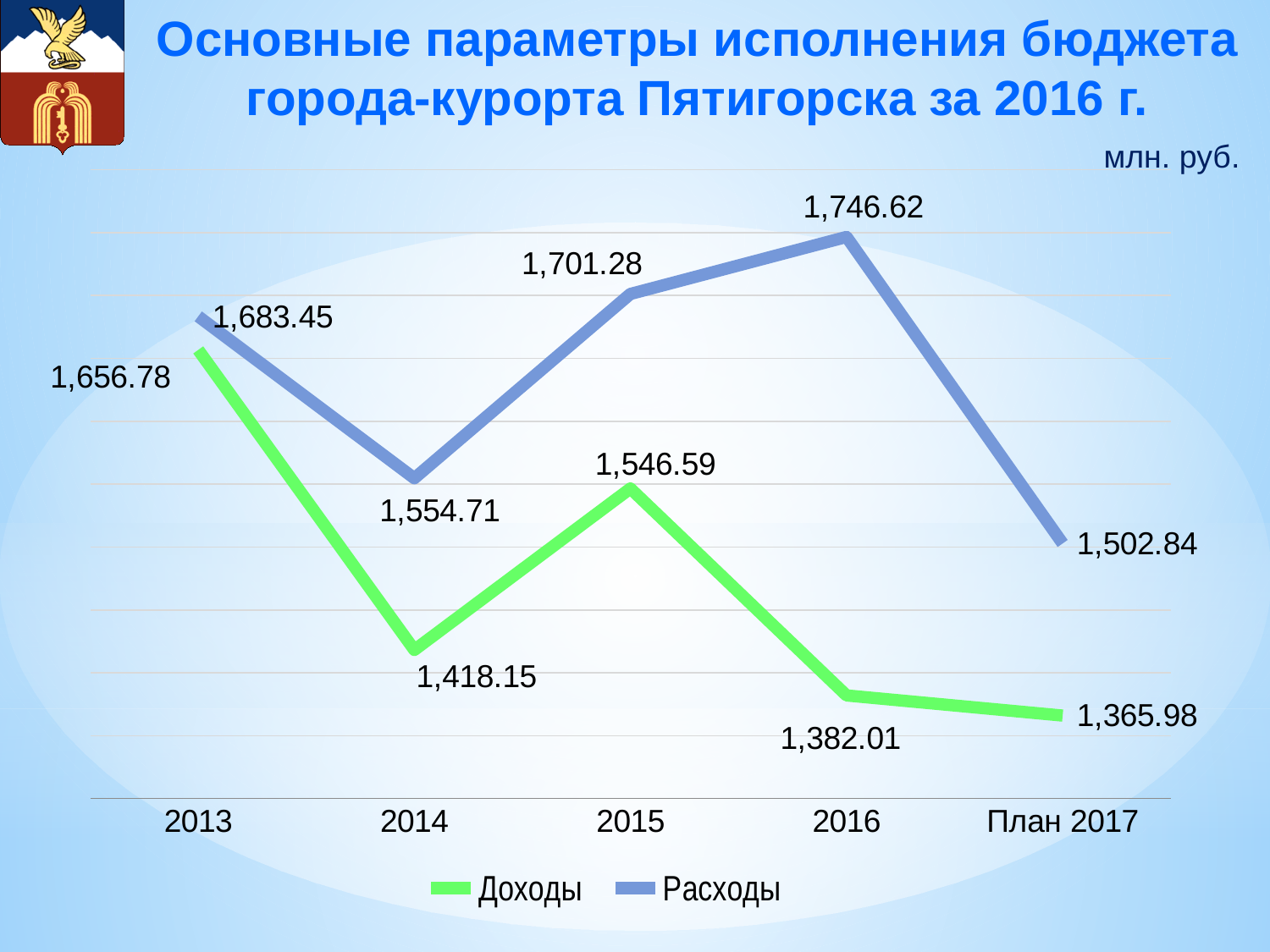
What is the value of Расходы for 2015? 1,701.28 What is the value of Доходы for 2014? 1,418.15 What unit is indicated for the values on the chart? млн. руб. How many categories are shown on the x axis? 5 What is the value of Доходы for План 2017? 1,365.98 Which is larger in 2013, Доходы or Расходы? Расходы By how much did Расходы fall from 2016 to План 2017? 243.78 What kind of chart is shown on the slide? Line chart How many series does the legend list? 2 In which category is Доходы lowest? План 2017 What is the difference between Расходы and Доходы in 2016? 364.61 In which year does Расходы reach its highest value? 2016